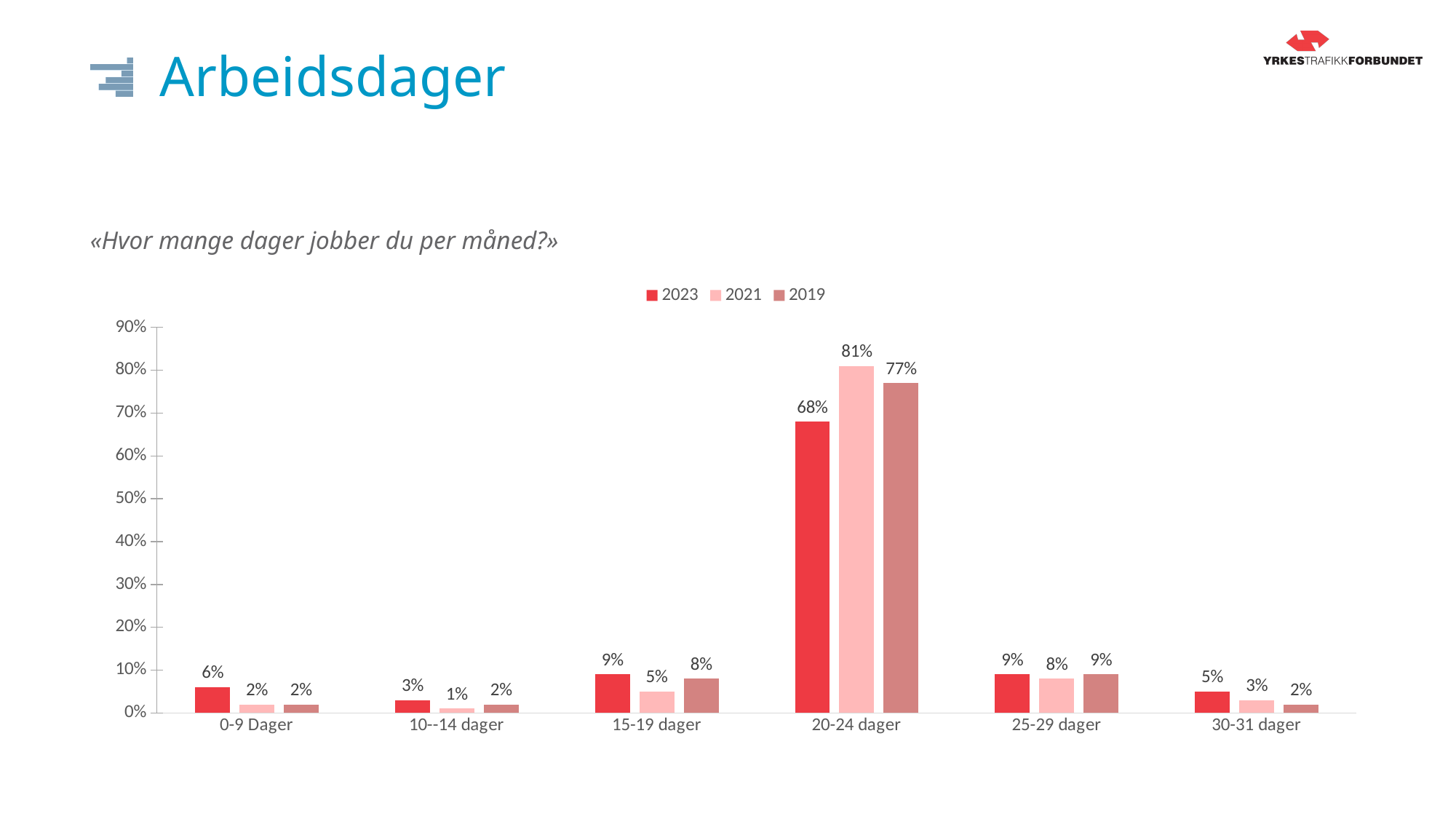
How many categories are shown on the x axis? 6 Is the value for 2019 in the 20-24 dager category greater or less than 70%? greater What kind of chart is shown on the slide? bar chart How many series does the legend list? 3 Which category has the highest value for the 2021 series? 20-24 dager Which category has the lowest value for the 2021 series? 10--14 dager What is the difference between the 2021 and 2023 values in the 20-24 dager category? 13% What question is the chart based on, as written in italics above it? «Hvor mange dager jobber du per måned?» What is the value for 2021 in the 15-19 dager category? 5% In the 0-9 Dager category, which series has the larger value, 2023 or 2019? 2023 What is the value for 2019 in the 30-31 dager category? 2% What is the value for 2023 in the 20-24 dager category? 68%